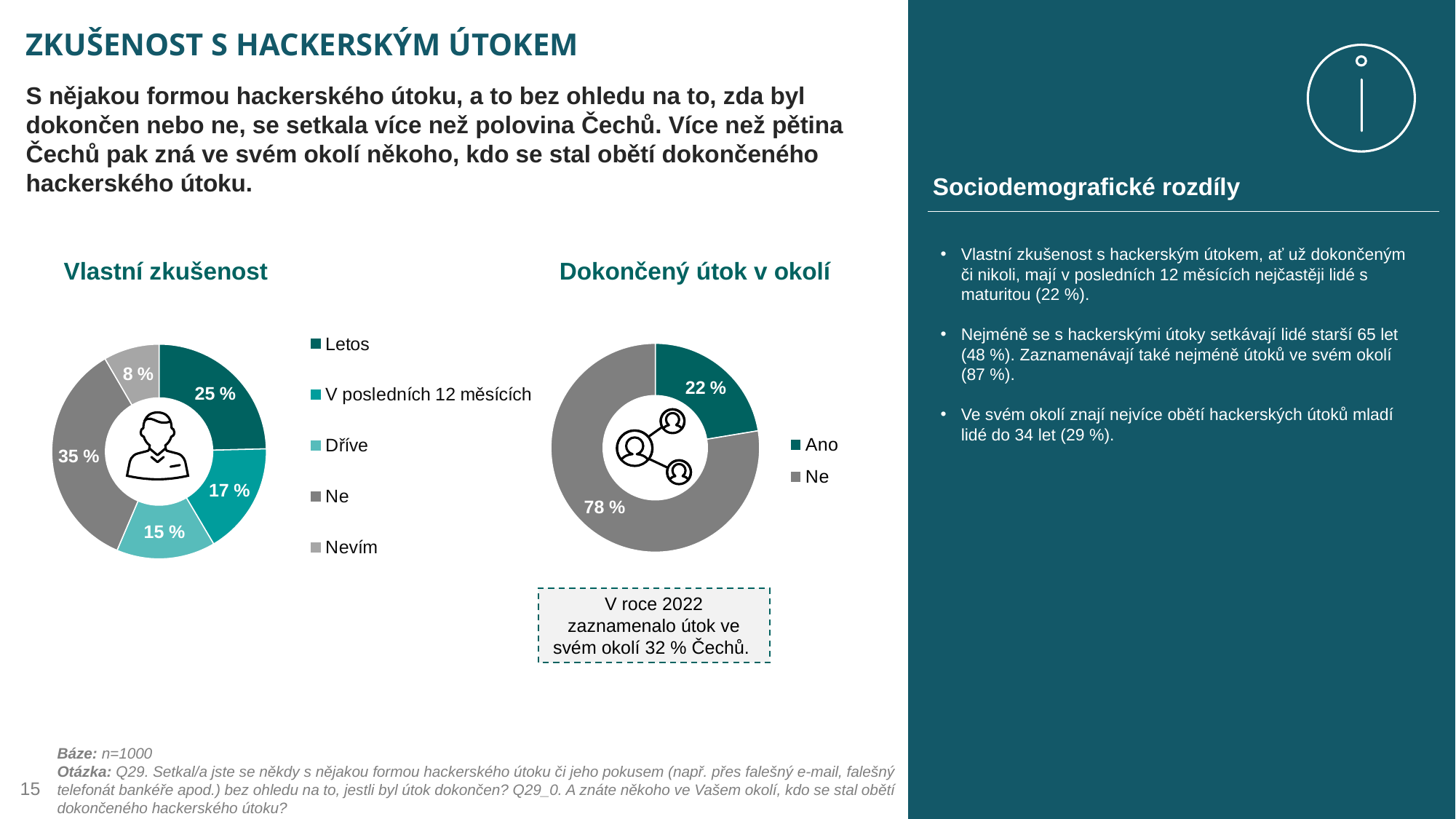
In the 'Vlastní zkušenost' chart, what is the difference between 'Ne' and 'Dříve'? 20 % In the 'Vlastní zkušenost' chart, what is the value for 'Letos'? 25 % In the 'Dokončený útok v okolí' chart, what is the difference between 'Ne' and 'Ano'? 56 % How many categories does the legend of the 'Vlastní zkušenost' chart list? 5 In the 'Dokončený útok v okolí' chart, what is the value for 'Ano'? 22 % What type of chart is the 'Dokončený útok v okolí' chart? Donut (pie) chart In the 'Vlastní zkušenost' chart, which category has the largest share? Ne In the 'Vlastní zkušenost' chart, which category has the smallest share? Nevím In the 'Vlastní zkušenost' chart, what is the value for 'V posledních 12 měsících'? 17 % In the 'Vlastní zkušenost' chart, what is the value for 'Nevím'? 8 % In the 'Vlastní zkušenost' chart, which is larger: 'Letos' or 'Dříve'? Letos In the 'Dokončený útok v okolí' chart, what is the value for 'Ne'? 78 %